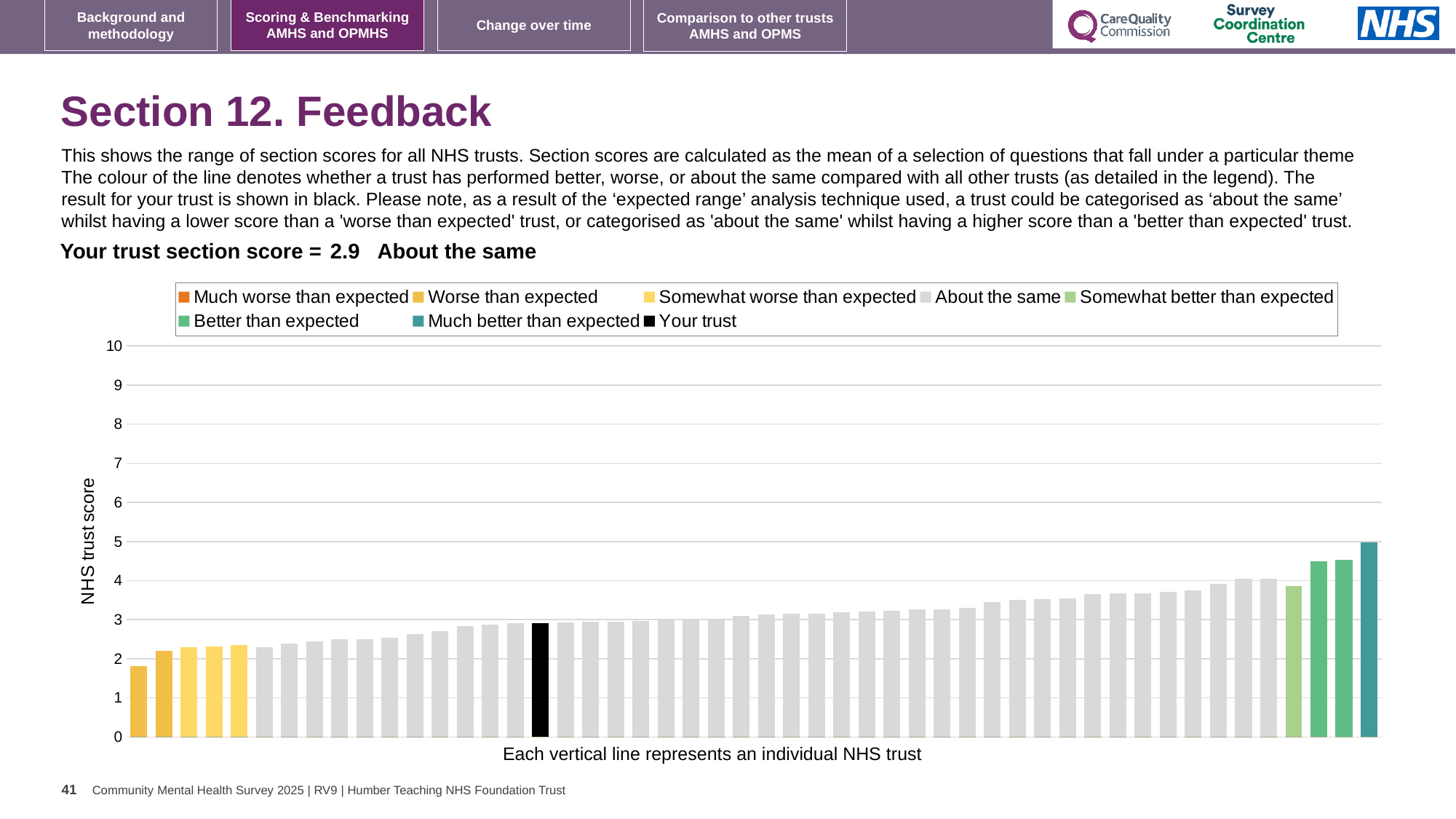
Do the bar values rise or fall from left to right along the x axis? rise What is the section score for your trust shown on the slide? 2.9 Which legend category does the tallest bar in the chart belong to? Much better than expected Is the value of the tallest bar in the chart greater or less than 6? less What kind of chart is shown on the slide? bar chart How many entries does the chart legend list? 8 Is the value of the tallest bar in the chart greater or less than 4? greater Which category is your trust placed in for this section? About the same Is the value of the black 'Your trust' bar greater or less than 2? greater What is the label on the vertical axis of the chart? NHS trust score Which legend category does the shortest bar in the chart belong to? Worse than expected